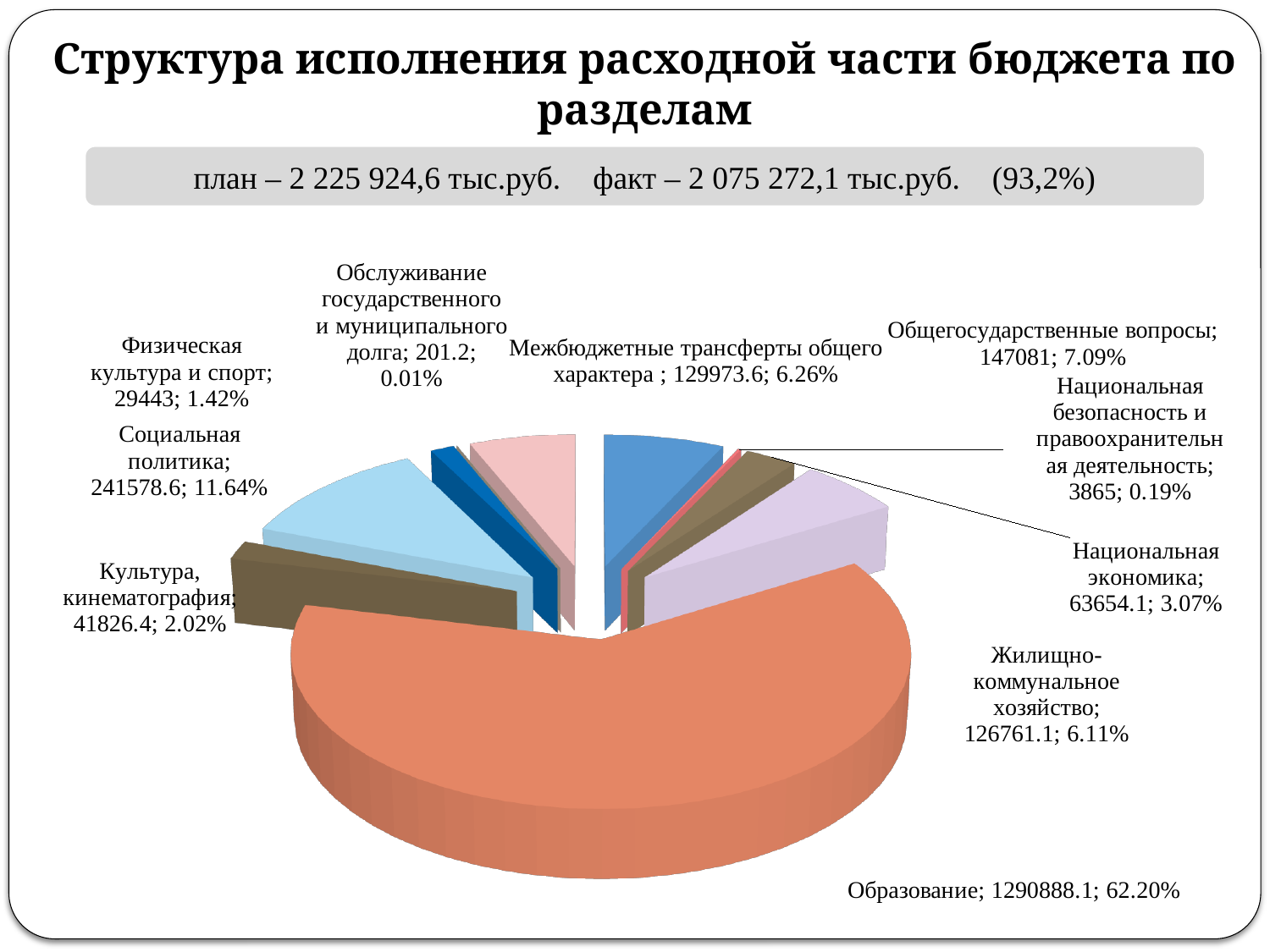
Which is larger: Общегосударственные вопросы or Межбюджетные трансферты общего характера? Общегосударственные вопросы How many categories (slices) does the pie chart show? 10 What is the value for Образование? 1290888.1 What kind of chart is shown on the slide? pie chart What is the title of the slide? Структура исполнения расходной части бюджета по разделам What share of the pie does Жилищно-коммунальное хозяйство represent? 6.11% Which category has the largest slice? Образование What is the difference between the values for Социальная политика and Общегосударственные вопросы? 94497.6 What is the value for Национальная безопасность и правоохранительная деятельность? 3865 Which category has the smallest slice? Обслуживание государственного и муниципального долга What share of the pie does Образование represent? 62.20% What is the value for Социальная политика? 241578.6